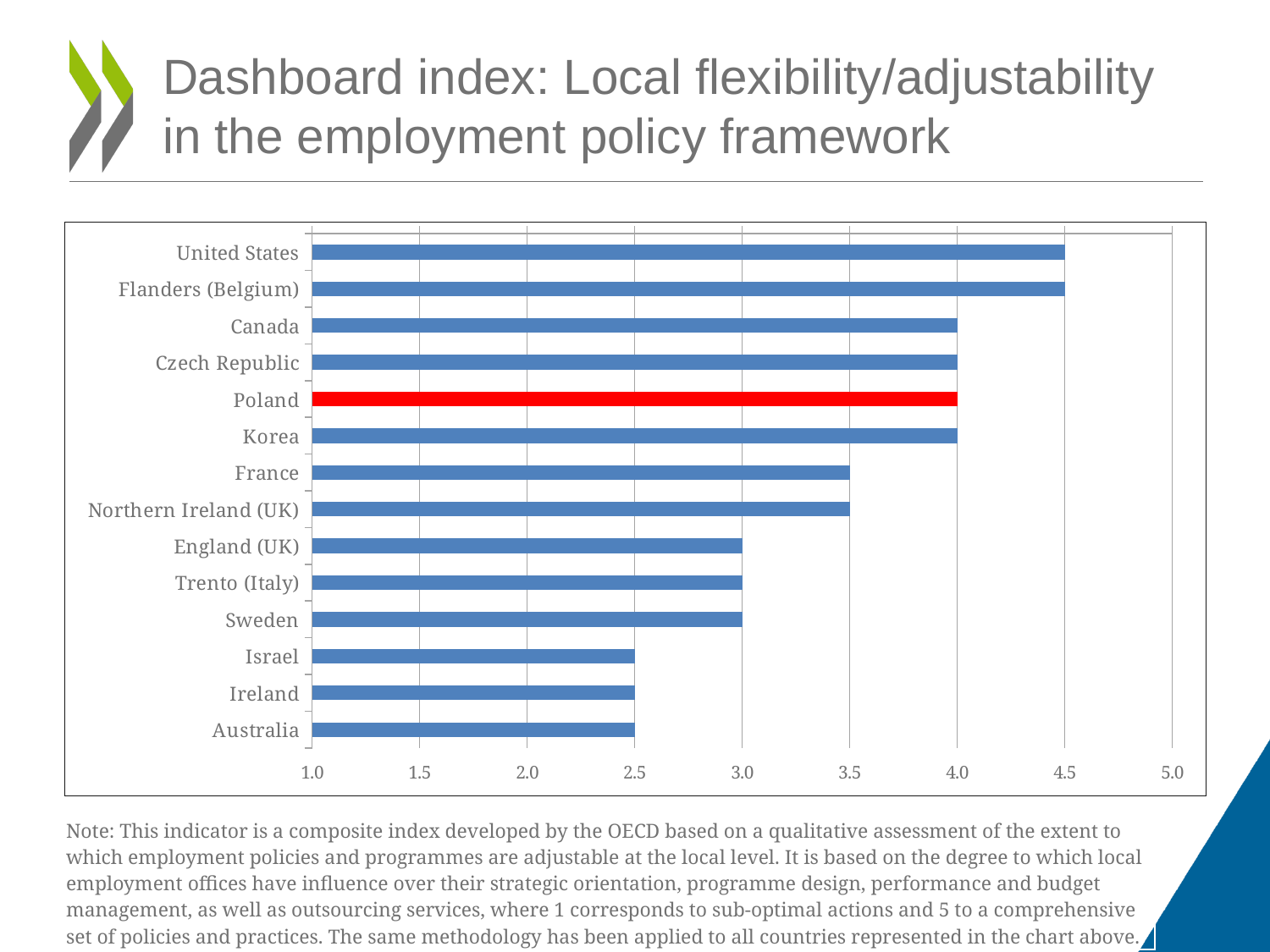
What is the dashboard index value for the United States? 4.5 What type of chart is shown on the slide? Bar chart What is the dashboard index value for Sweden? 3.0 Is the value for Korea greater or less than 3.5? greater Which has a higher index value, Canada or England (UK)? Canada Which bar is coloured red in the chart? Poland Do the bar values rise or fall going down the chart from United States to Australia? Fall What is the dashboard index value for France? 3.5 What is the dashboard index value for Australia? 2.5 What is the difference between the index values of Flanders (Belgium) and Israel? 2.0 How many countries or regions are shown in the chart? 14 What is the dashboard index value for Poland? 4.0